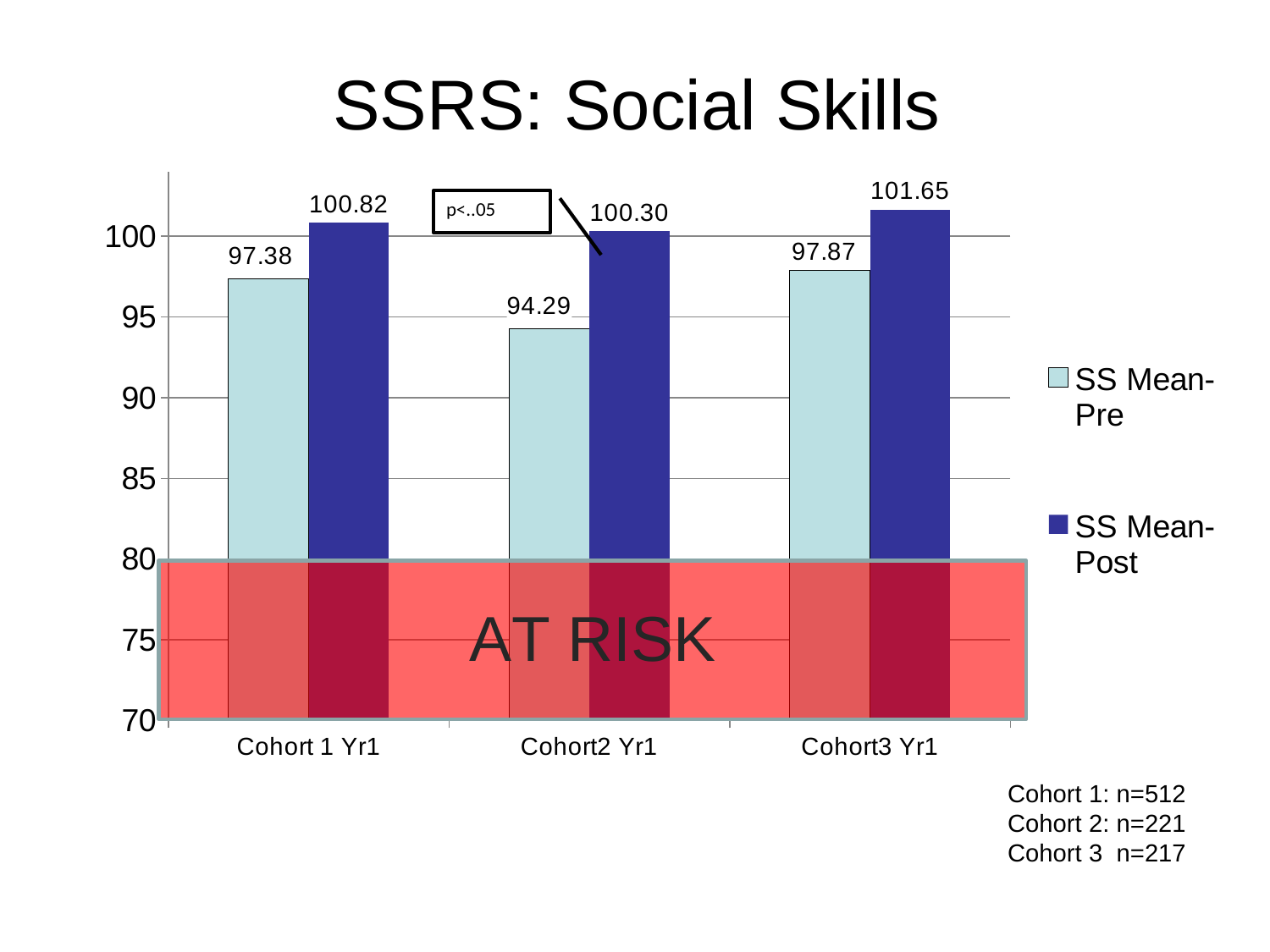
What is the difference between the SS Mean-Post and SS Mean-Pre values for Cohort 1 Yr1? 3.44 Which cohort has the lowest SS Mean-Pre value? Cohort2 Yr1 What is the SS Mean-Pre value for Cohort 1 Yr1? 97.38 How many cohorts are shown on the x axis? 3 What kind of chart is shown on the slide? bar chart Is the SS Mean-Pre value for Cohort2 Yr1 greater or less than 95? less Which cohort has the highest SS Mean-Post value? Cohort3 Yr1 What is the difference between the SS Mean-Post and SS Mean-Pre values for Cohort2 Yr1? 6.01 How many series does the legend list? 2 What is the SS Mean-Post value for Cohort2 Yr1? 100.30 Which is larger, the SS Mean-Pre value for Cohort 1 Yr1 or for Cohort3 Yr1? Cohort3 Yr1 What is the SS Mean-Post value for Cohort3 Yr1? 101.65